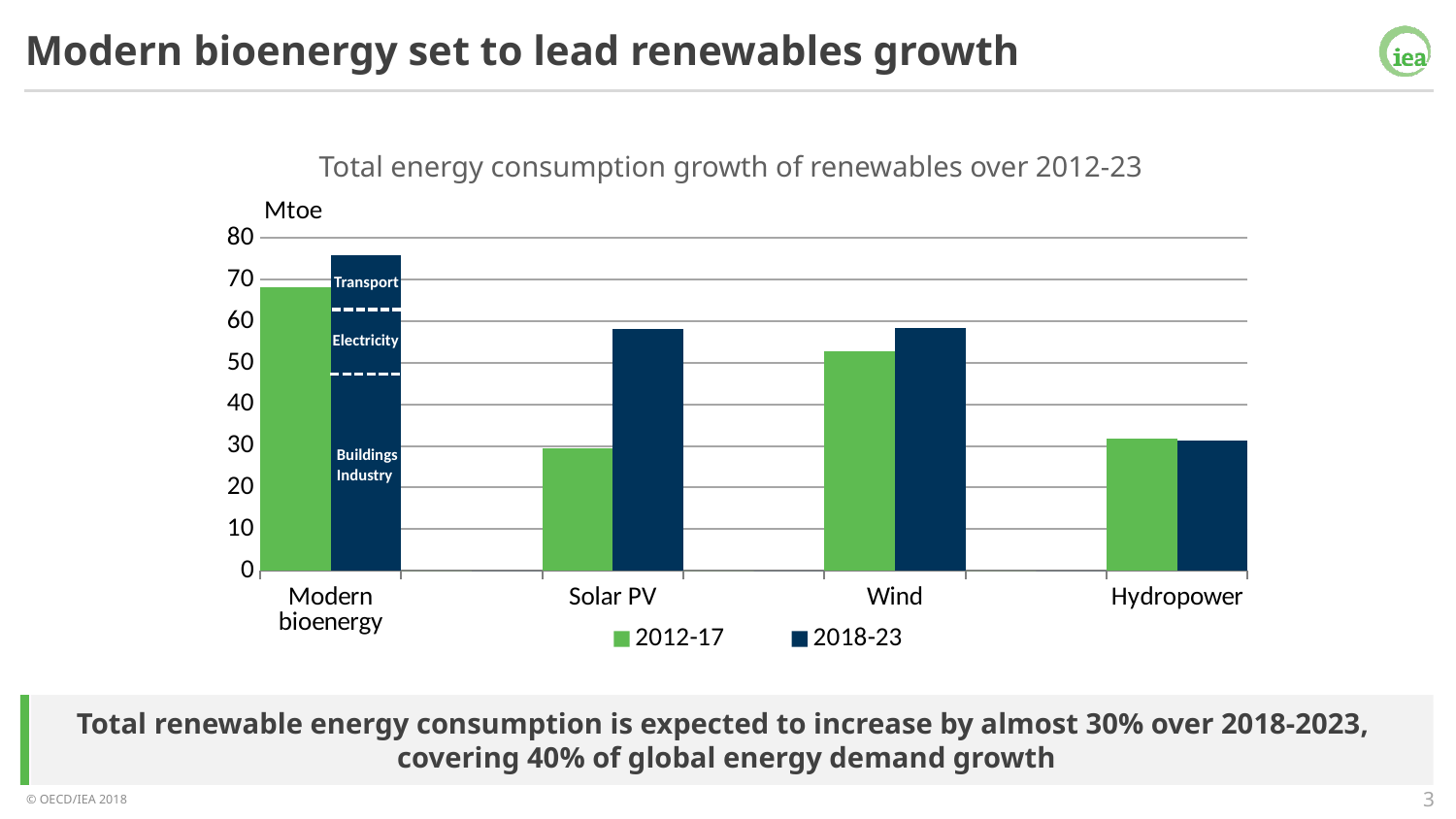
Which category has the highest value for the 2012-17 series? Modern bioenergy What is the title of the chart? Total energy consumption growth of renewables over 2012-23 Is the 2012-17 value for Solar PV greater or less than 40? less Is the 2018-23 value for Hydropower greater or less than 40? less For Solar PV, which series has the larger value, 2012-17 or 2018-23? 2018-23 Is the 2018-23 value for Modern bioenergy greater or less than 70? greater Which is larger, the 2012-17 value for Wind or the 2012-17 value for Solar PV? Wind How many categories are shown on the x axis of the chart? 4 How many series does the chart's legend list? 2 Which category has the highest value for the 2018-23 series? Modern bioenergy What unit is shown on the vertical axis of the chart? Mtoe What kind of chart is shown on the slide? Bar chart